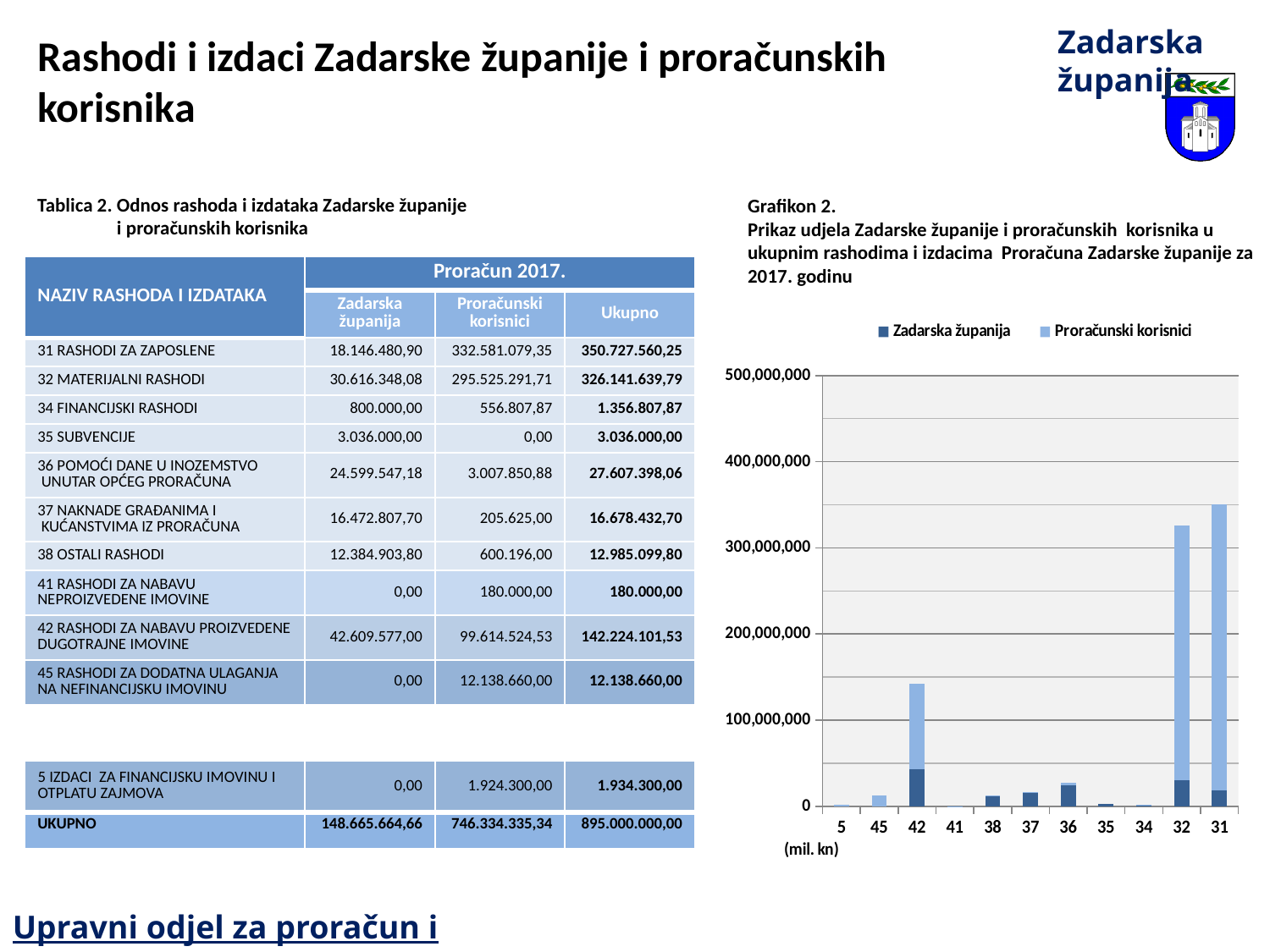
What unit label is shown below the x axis of Grafikon 2? (mil. kn) In Grafikon 2, is the total bar for category 31 greater or less than 300,000,000? greater What kind of chart is Grafikon 2? bar chart In Grafikon 2, is the total bar for category 36 greater or less than 100,000,000? less How many categories are shown on the x axis of Grafikon 2? 11 What are the two legend entries in Grafikon 2? Zadarska županija, Proračunski korisnici In Grafikon 2, which category has the tallest stacked bar? 31 In Grafikon 2, is the total bar for category 42 greater or less than 200,000,000? less In Grafikon 2, which stacked bar is taller, category 31 or category 32? 31 How many series does the legend of Grafikon 2 list? 2 In Grafikon 2, which stacked bar is taller, category 42 or category 38? 42